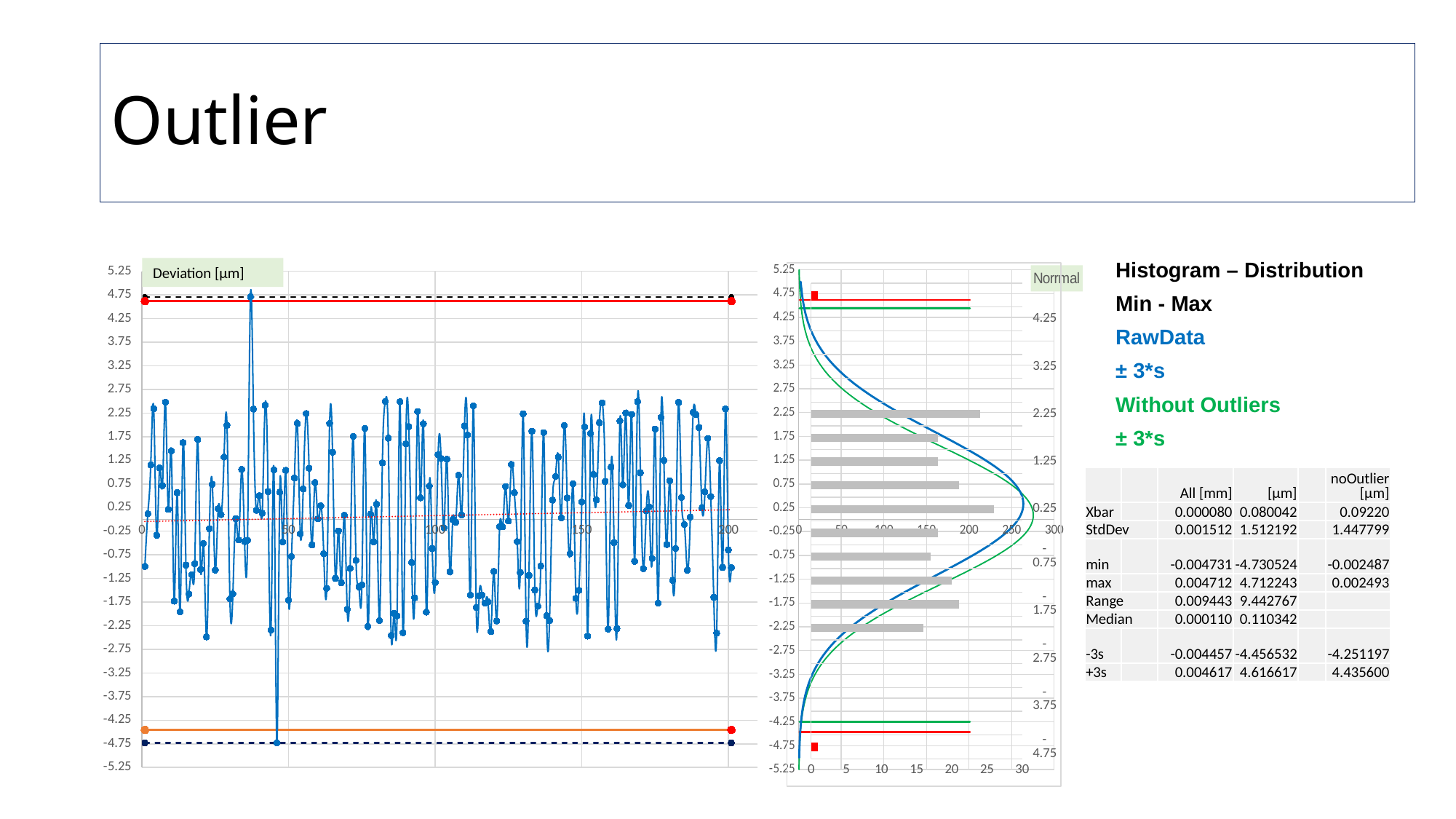
What legend entry is shown on the right chart? Norrmal In the right chart, is the gray bar at -2.25 greater or less than 200 on the top axis? less In the right chart, is the gray bar at 0.75 greater or less than 200 on the top axis? less In the right chart, which gray bar is longer, the one at 0.25 or the one at 1.25? 0.25 What kind of chart is the right chart with the gray horizontal bars? bar chart What is the title of the left chart? Deviation [µm] How many gray bars are plotted in the right chart? 10 What kind of chart is the left chart titled "Deviation [µm]"? line chart In the right chart, is the gray bar at 0.25 greater or less than 200 on the top axis? greater In the right chart, which y-axis bin has the longest gray bar? 0.25